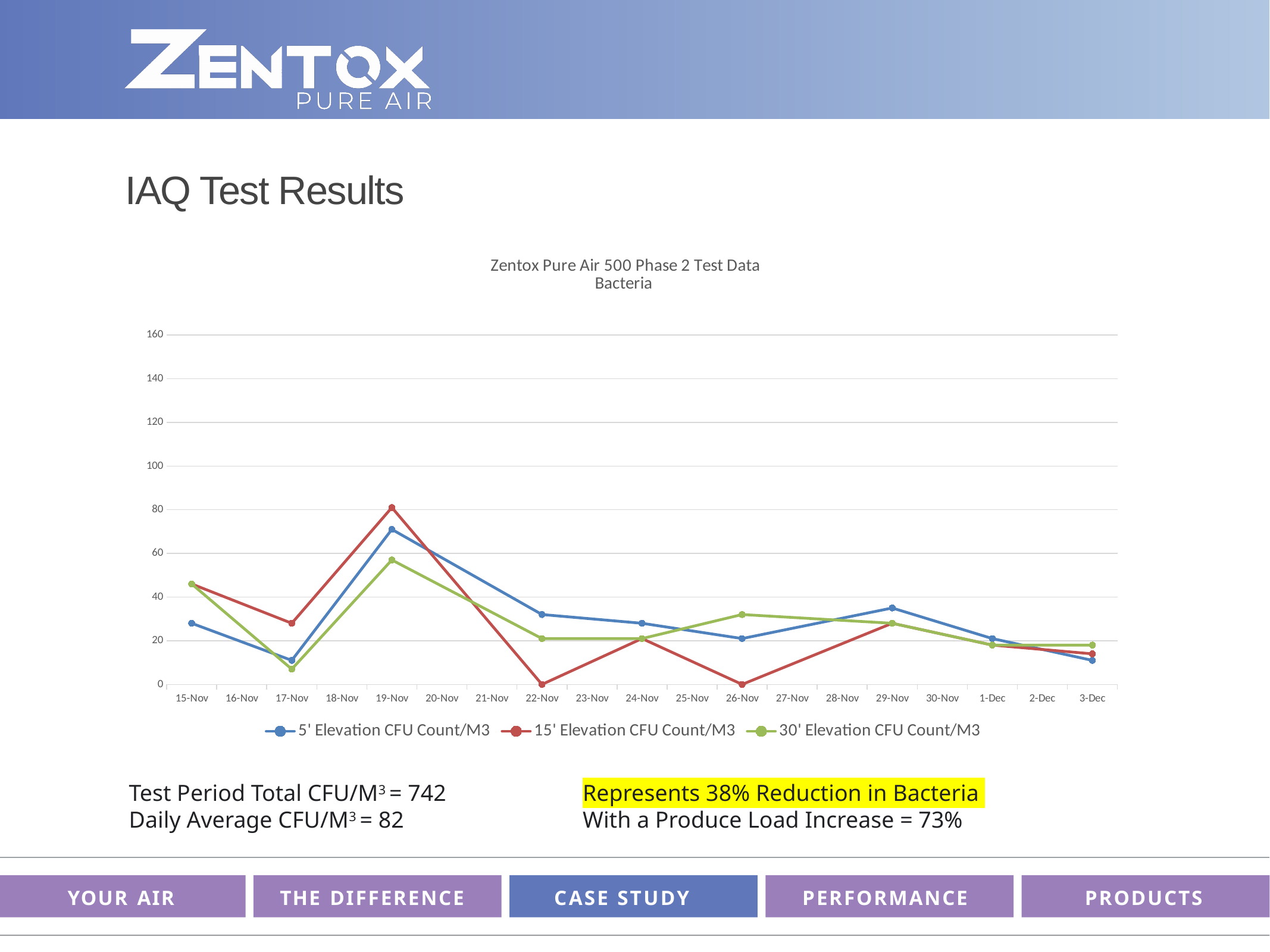
On 19-Nov, which series has the larger value: 5' Elevation CFU Count/M3 or 15' Elevation CFU Count/M3? 15' Elevation CFU Count/M3 What kind of chart is shown on the slide? line chart How many dates are plotted along the x axis? 19 On which date does the 30' Elevation CFU Count/M3 series reach its lowest value? 17-Nov How many series does the legend list? 3 Is the 30' Elevation CFU Count/M3 value on 17-Nov greater or less than 20? less Is the 15' Elevation CFU Count/M3 value on 19-Nov greater or less than 60? greater What is the 15' Elevation CFU Count/M3 value on 26-Nov? 0 What is the 15' Elevation CFU Count/M3 value on 22-Nov? 0 Is the 5' Elevation CFU Count/M3 value on 15-Nov greater or less than 40? less What is the title of the chart? Zentox Pure Air 500 Phase 2 Test Data Bacteria On which date does the 15' Elevation CFU Count/M3 series reach its highest value? 19-Nov